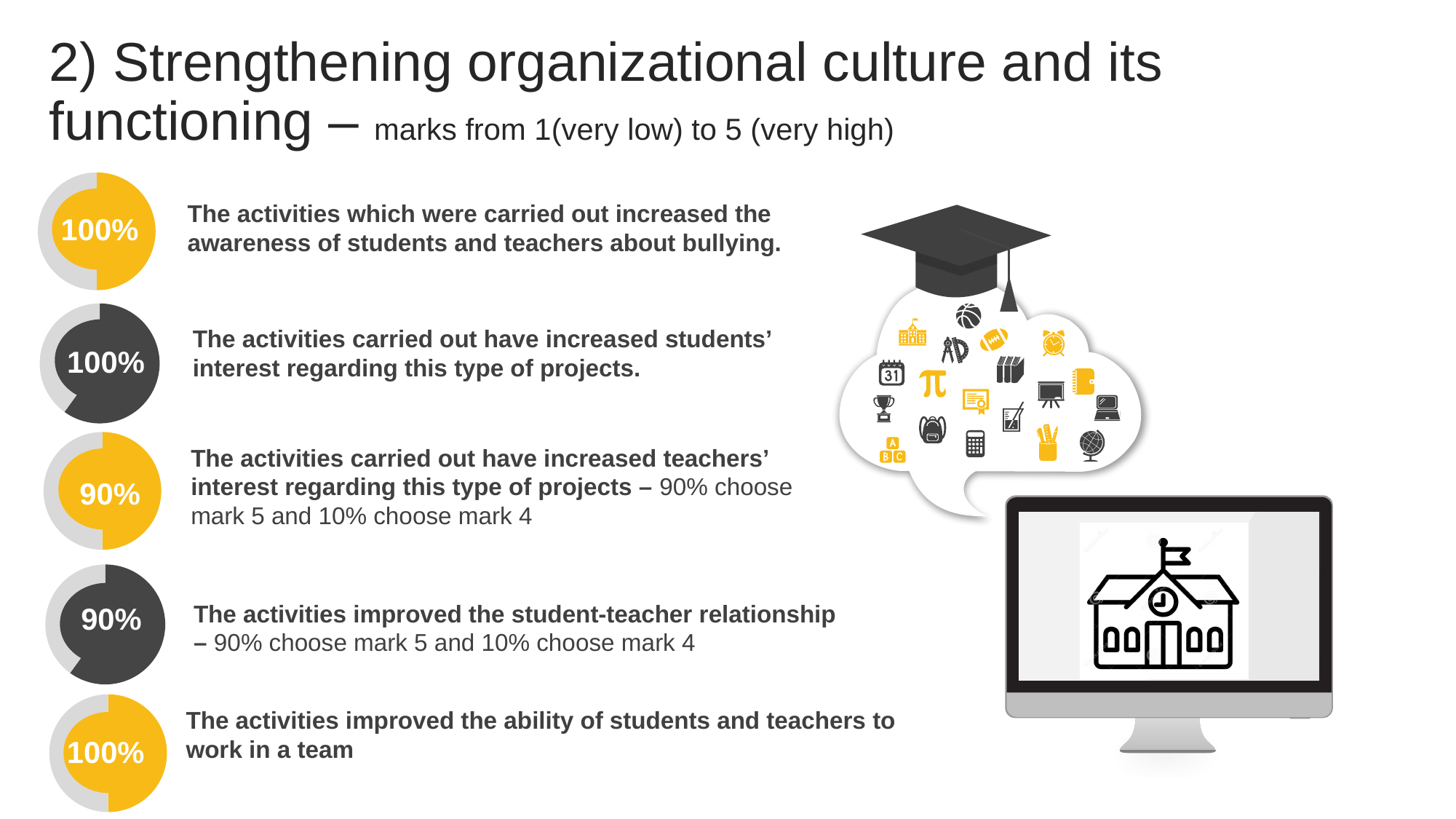
What percentage is shown for the statement that the activities improved the ability of students and teachers to work in a team? 100% What percentage is shown for the statement that the activities increased students' interest regarding this type of projects? 100% How many circular percentage indicators are shown on the slide? 5 What two colours are used for the filled portions of the circular indicators? Yellow and dark grey What is the difference between the percentage for improved teamwork ability and the percentage for improved student-teacher relationship? 10% What percentage is shown for the statement that the activities increased teachers' interest regarding this type of projects? 90% What is the highest percentage value shown among the circular indicators? 100% What percentage is shown for the statement that the activities improved the student-teacher relationship? 90% What kind of chart is used to display the percentages on the slide? Doughnut (circular progress) chart Which is larger: the percentage for increased awareness about bullying or the percentage for increased teachers' interest? Increased awareness about bullying What is the lowest percentage value shown among the circular indicators? 90% What percentage is shown for the statement that the activities increased the awareness of students and teachers about bullying? 100%